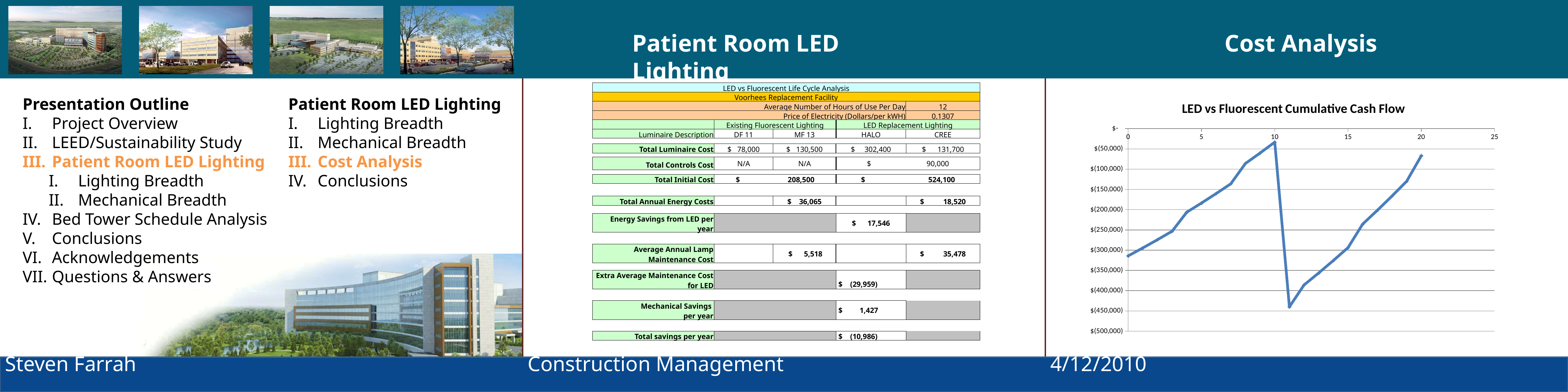
In the LED vs Fluorescent Cumulative Cash Flow chart, is the lowest point of the line greater or less than $(400,000)? less In the LED vs Fluorescent Cumulative Cash Flow chart, is the value at x = 10 greater or less than $(50,000)? greater In the LED vs Fluorescent Cumulative Cash Flow chart, is the value at x = 0 greater or less than $(300,000)? less In the LED vs Fluorescent Cumulative Cash Flow chart, does the line rise or fall between x = 0 and x = 10? rise What kind of chart is shown on the right side of the slide? line chart What is the title of the chart on the slide? LED vs Fluorescent Cumulative Cash Flow How many tick labels are shown on the x axis of the LED vs Fluorescent Cumulative Cash Flow chart? 6 In the LED vs Fluorescent Cumulative Cash Flow chart, which is higher: the value at x = 10 or the value at x = 20? x = 10 What is the lowest label shown on the y axis of the LED vs Fluorescent Cumulative Cash Flow chart? $(500,000) In the LED vs Fluorescent Cumulative Cash Flow chart, does the line rise or fall between x = 15 and x = 20? rise In the LED vs Fluorescent Cumulative Cash Flow chart, at which x-axis tick does the line reach its highest point before the sharp drop? 10